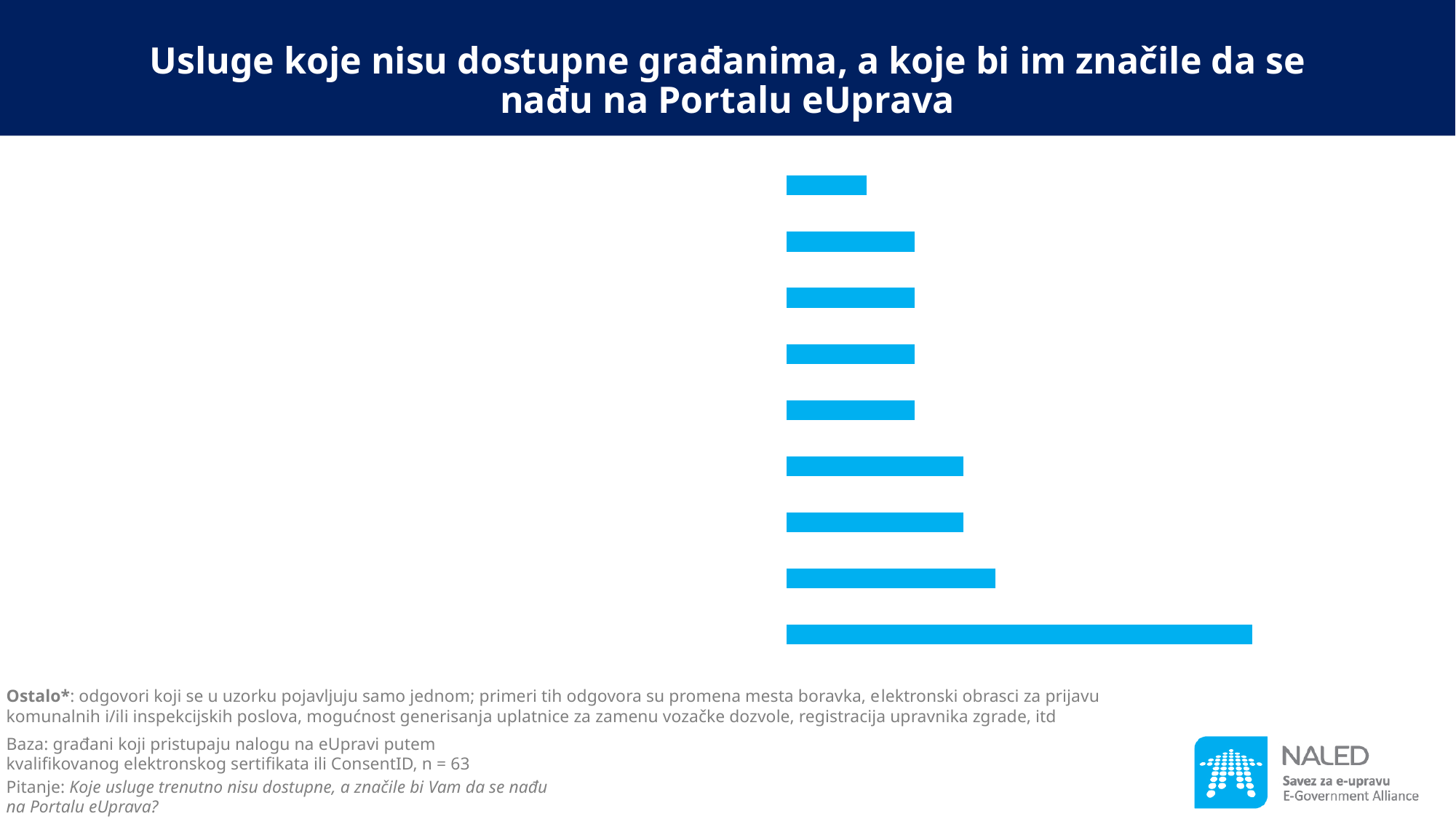
What kind of chart is shown on the slide? bar chart What is the title of the slide containing the chart? Usluge koje nisu dostupne građanima, a koje bi im značile da se nađu na Portalu eUprava Which bar in the chart is the longest: the top one or the bottom one? the bottom one What colour are the bars in the chart? blue Do the bars in the chart generally get longer or shorter going from top to bottom? longer Is the second bar from the top longer or shorter than the second bar from the bottom? shorter How many bars does the chart on the slide contain? 9 Which bar in the chart is the shortest: the top one or the bottom one? the top one